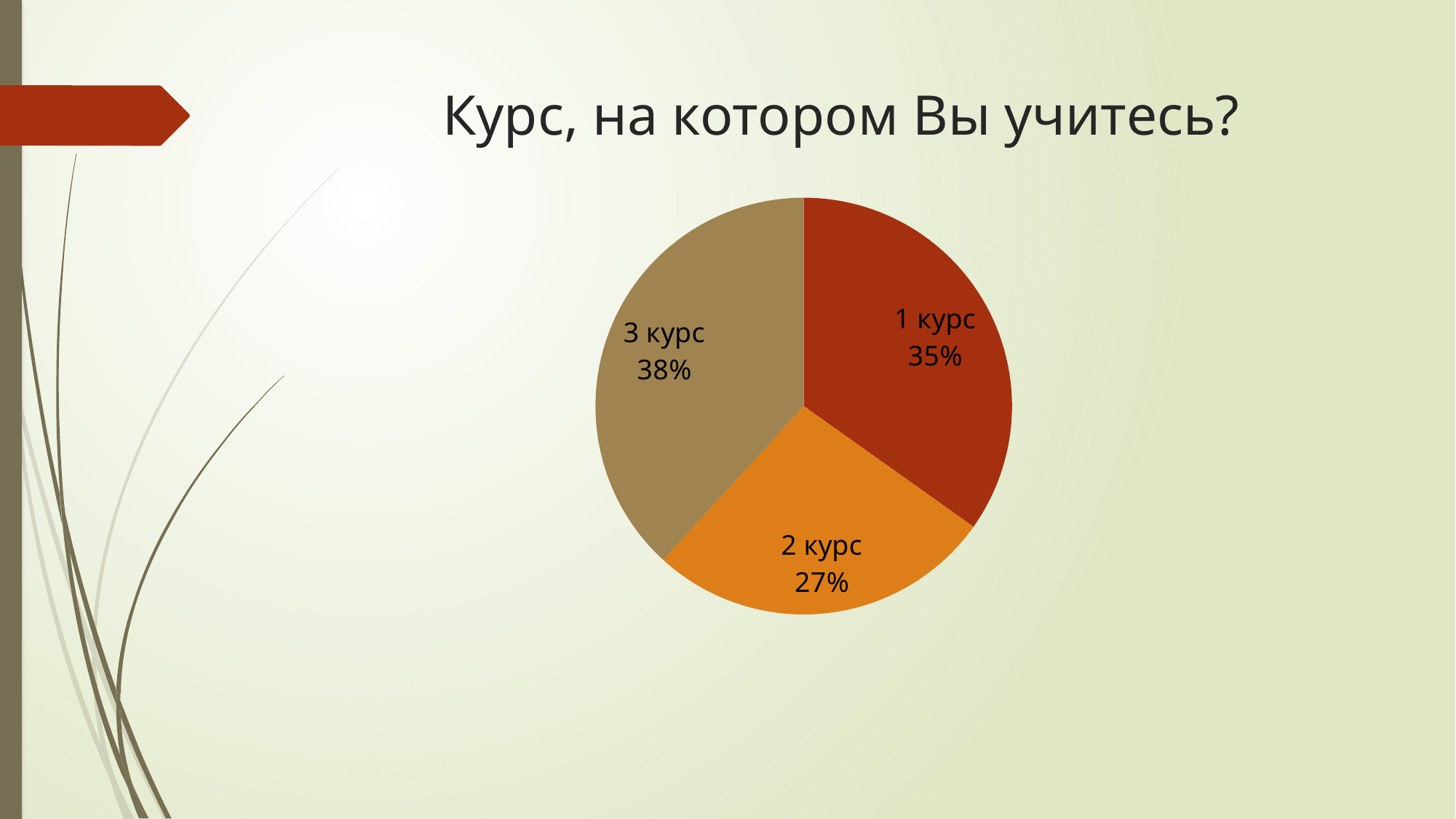
What is the difference in percentage points between 1 курс and 2 курс? 8 Which category has the largest slice of the pie? 3 курс What share of the pie is labelled 1 курс? 35% Which is larger, the share for 1 курс or the share for 2 курс? 1 курс What colour is the slice for 2 курс? orange Which category has the smallest slice of the pie? 2 курс How many slices does the pie chart have? 3 What kind of chart is shown on the slide? pie chart What is the title of the chart? Курс, на котором Вы учитесь? What share of the pie is labelled 3 курс? 38% What share of the pie is labelled 2 курс? 27% What is the difference in percentage points between 3 курс and 2 курс? 11